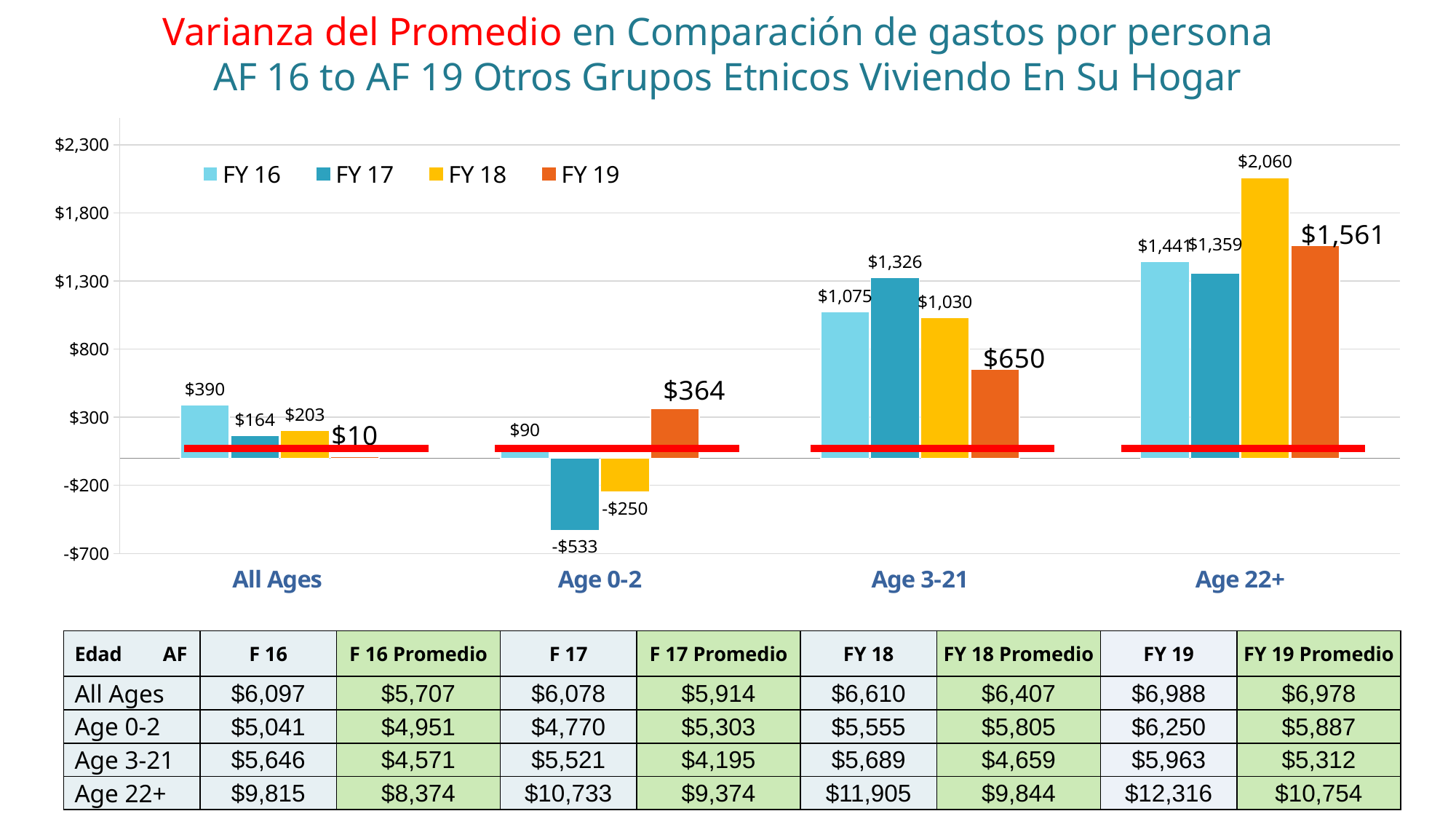
Which age group has the highest FY 19 value? Age 22+ What is the FY 18 value for Age 22+? $2,060 What kind of chart is shown on the slide? Bar chart Which age group has the lowest FY 17 value? Age 0-2 How many series does the chart legend list? 4 For Age 3-21, which is larger: the FY 17 value or the FY 19 value? FY 17 What is the difference between the FY 18 and FY 16 values for Age 22+? $619 What is the FY 17 value for Age 0-2? -$533 How many age groups are shown on the x axis of the chart? 4 What is the FY 16 value for Age 3-21? $1,075 Which series is shown in orange in the chart legend? FY 19 What is the FY 19 value for All Ages? $10